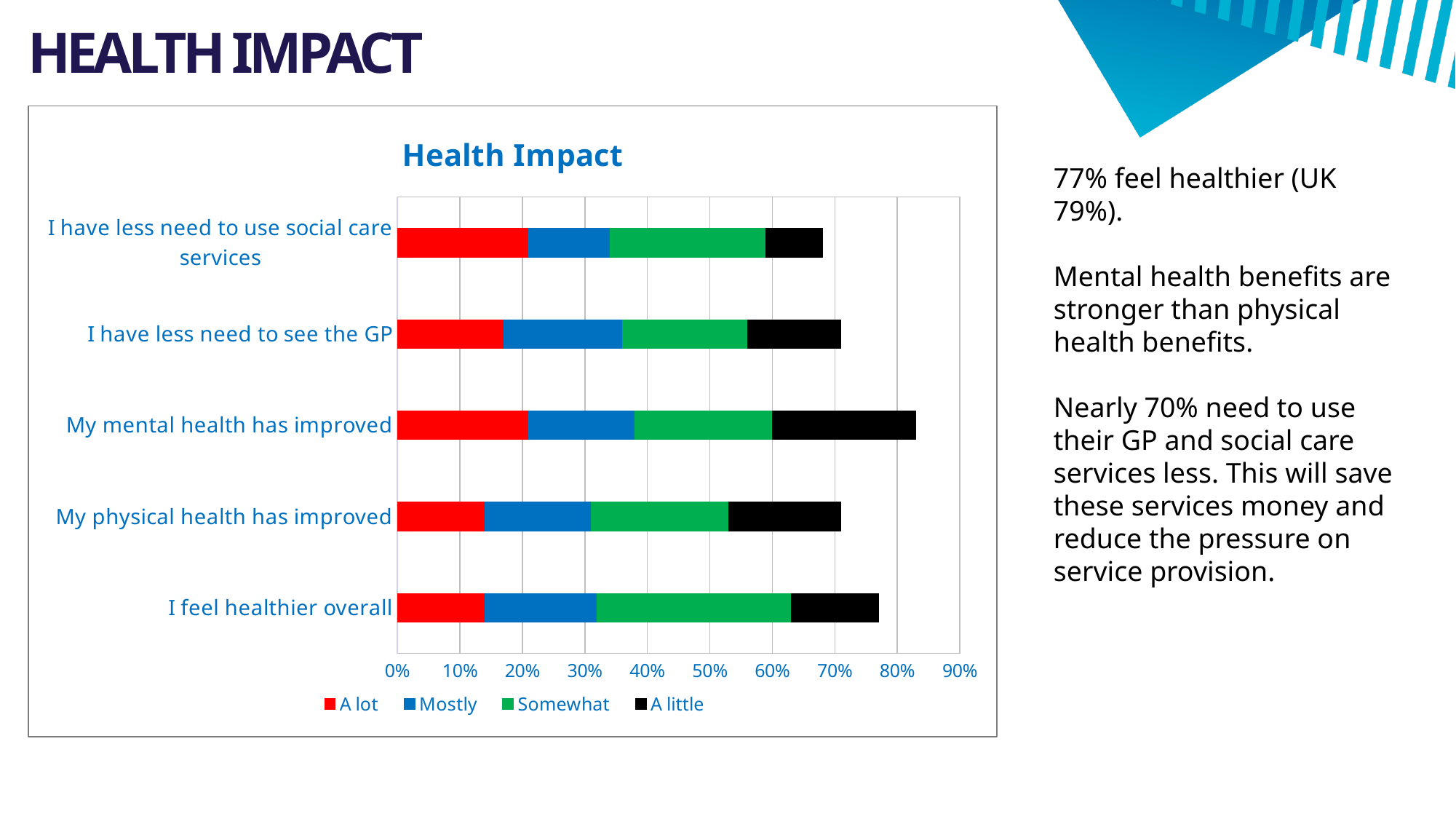
Is the total bar for "I feel healthier overall" greater or less than 70%? greater Which has the longer total bar: "I feel healthier overall" or "I have less need to use social care services"? I feel healthier overall What is the title of the chart? Health Impact Which statement has the longest total bar in the chart? My mental health has improved What colour represents the "A lot" series in the chart? Red What kind of chart is shown on the slide? Stacked bar chart Is the total bar for "My physical health has improved" greater or less than 80%? less Is the total bar for "My mental health has improved" greater or less than 80%? greater Which has the longer total bar: "My mental health has improved" or "My physical health has improved"? My mental health has improved How many categories (statements) are plotted in the chart? 5 How many series does the chart legend list? 4